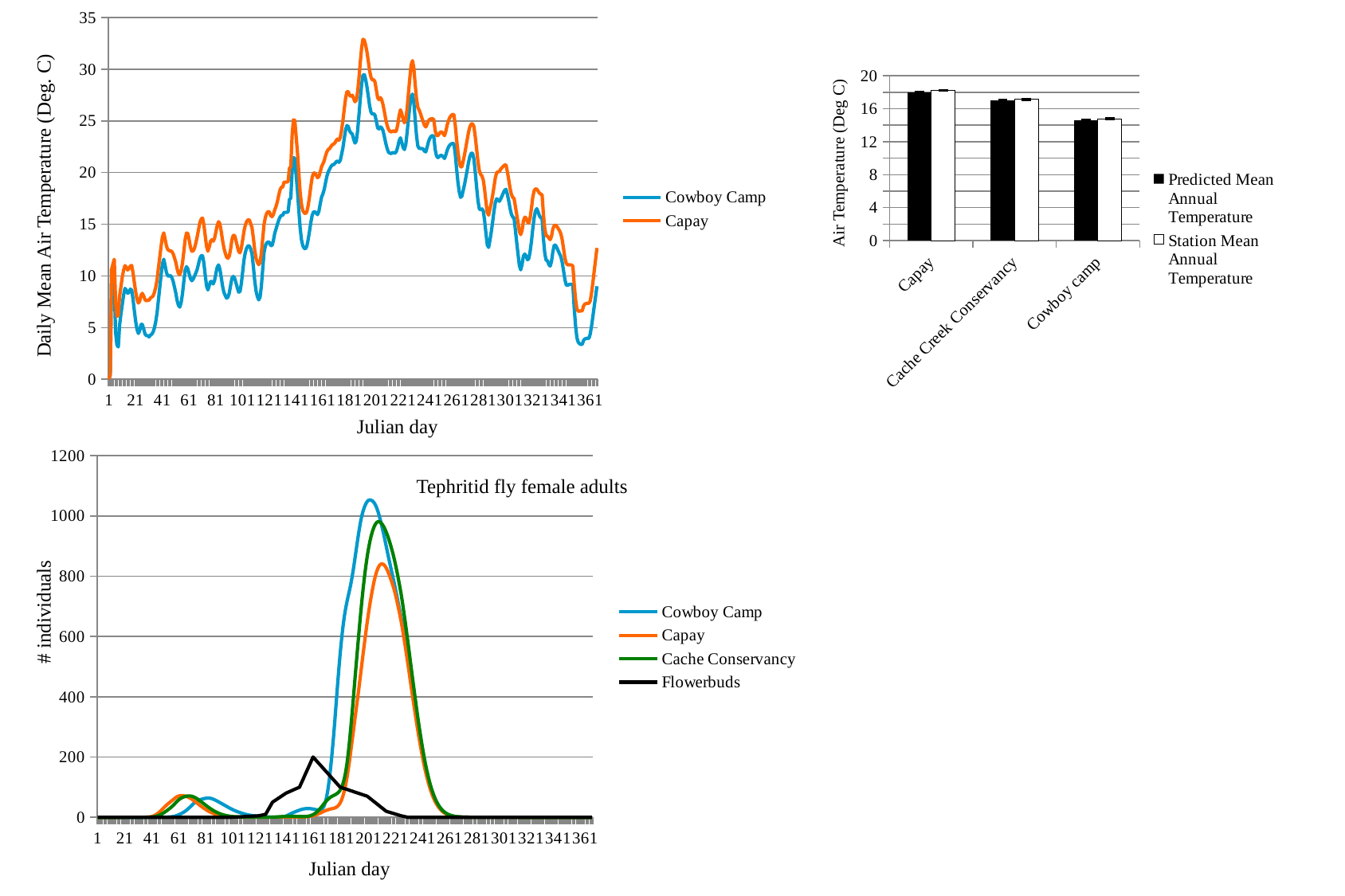
In the top-right bar chart, which category has the highest Predicted Mean Annual Temperature? Capay In the bottom-left chart 'Tephritid fly female adults', which series reaches the highest peak number of individuals? Cowboy Camp In the top-right bar chart, is the Predicted Mean Annual Temperature for Cowboy camp greater or less than 16? less In the top-left line chart of Daily Mean Air Temperature, how many series does the legend list? 2 In the top-right bar chart, is the Station Mean Annual Temperature for Capay greater or less than 16? greater In the top-left line chart of Daily Mean Air Temperature, is the highest value reached by Capay greater or less than 30? greater In the top-right bar chart, how many categories are shown on the x axis? 3 In the top-right bar chart, how many series does the legend list? 2 In the top-right bar chart, which category has the lowest Station Mean Annual Temperature? Cowboy camp In the bottom-left chart 'Tephritid fly female adults', how many series does the legend list? 4 What kind of chart is the top-right chart titled with the y-axis 'Air Temperature (Deg C)'? bar chart